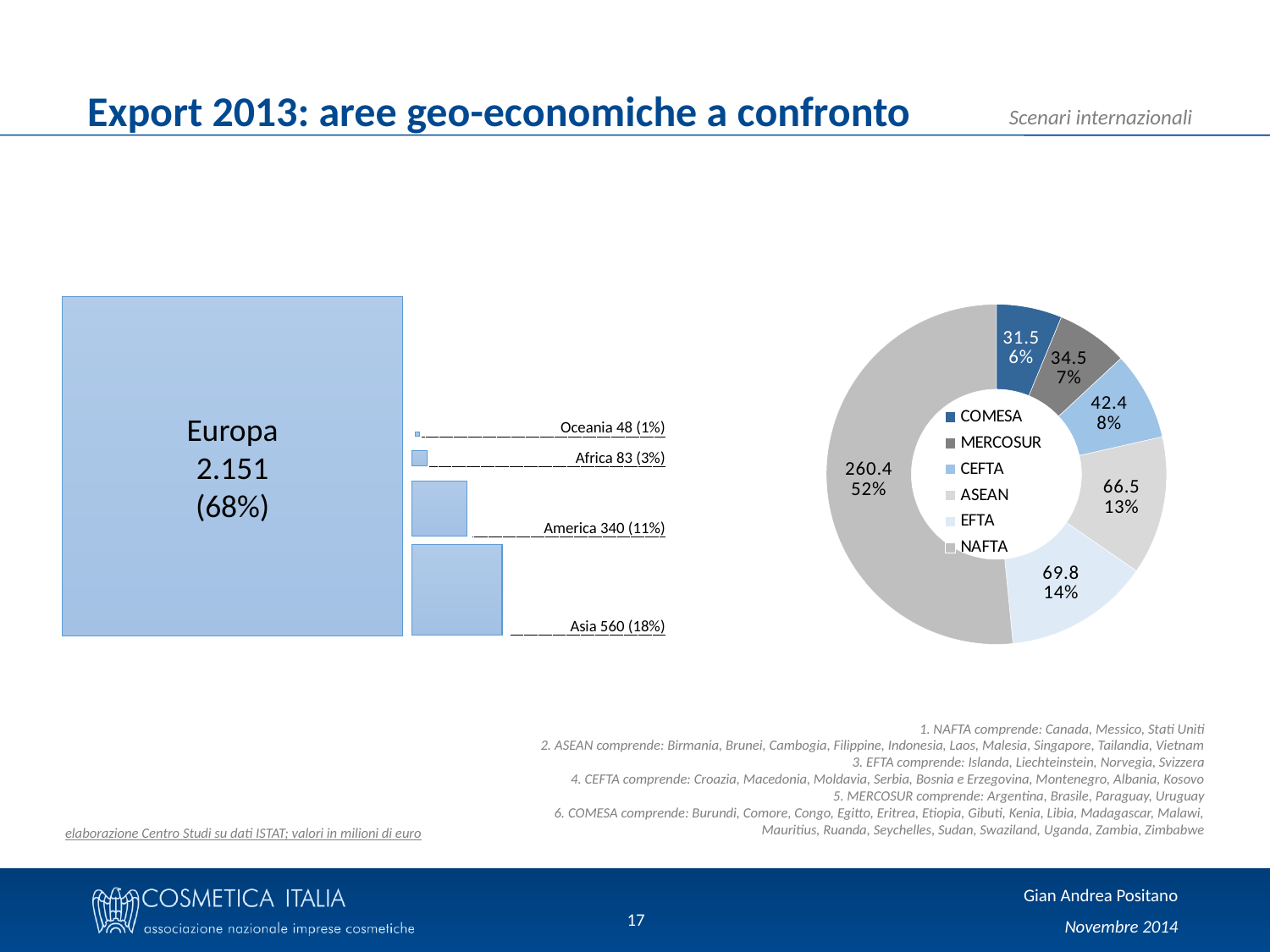
On the right doughnut chart, what value is shown for EFTA? 69.8 On the right doughnut chart, which area has the smallest value? COMESA On the left chart, what value is shown for Europa? 2.151 (68%) On the right doughnut chart, which area has the largest value? NAFTA On the left chart, which area has the lowest export value? Oceania On the left chart, which is larger, the value for Africa or the value for Oceania? Africa On the left chart, what value is shown for Asia? 560 (18%) On the right doughnut chart, how many entries does the legend list? 6 On the right doughnut chart, what percentage share does NAFTA have? 52% On the right doughnut chart, what is the difference between the values for ASEAN and CEFTA? 24.1 On the left chart, what is the difference between the values for Asia and America? 220 On the left chart, how many geographic areas are shown? 5